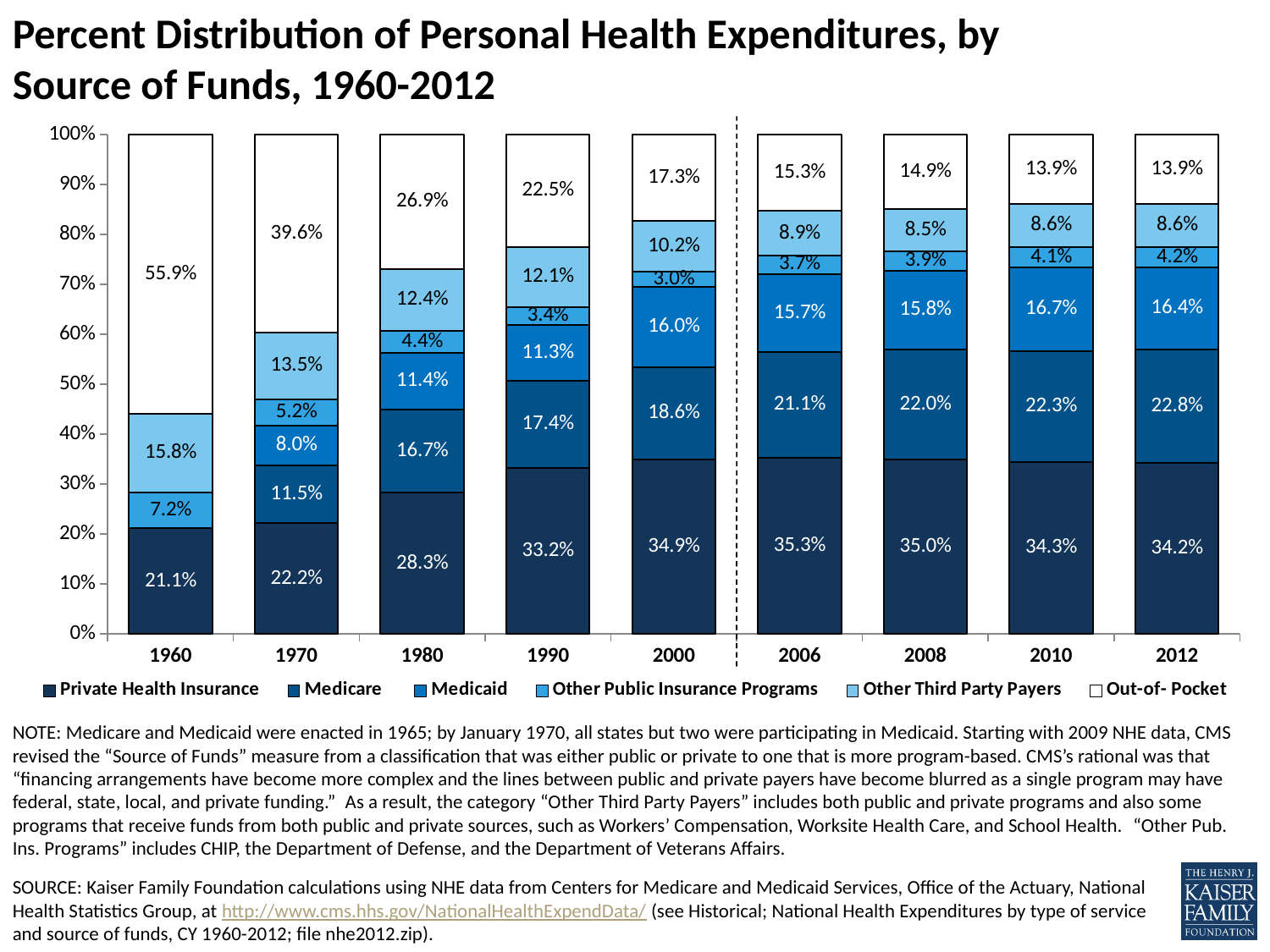
How many sources of funds does the legend list? 6 What kind of chart is shown on the slide? Stacked bar chart By how many percentage points did the Out-of-Pocket share fall from 1960 to 2012? 42.0 percentage points What is the Private Health Insurance share in 2012? 34.2% In 2012, which is larger: the Medicare share or the Medicaid share? Medicare How many years are shown on the x axis? 9 What is the Medicare share of personal health expenditures in 2000? 18.6% In which year is the Out-of-Pocket share the highest? 1960 What is the Medicaid share in 1980? 11.4% In which year is the Private Health Insurance share the lowest? 1960 Does the Out-of-Pocket share rise or fall from 1960 to 2012? Fall What percentage of personal health expenditures came from Out-of-Pocket in 1960? 55.9%